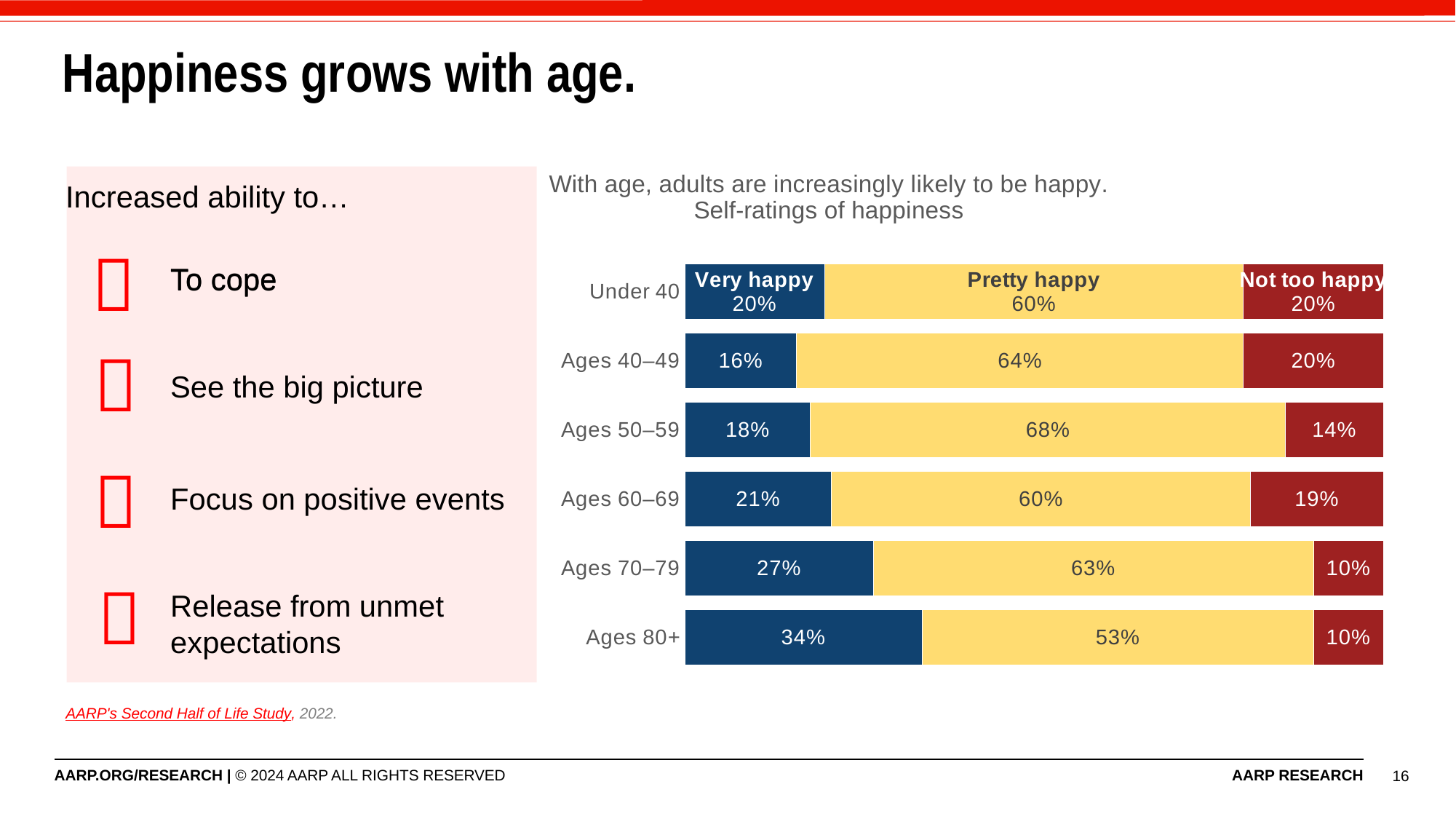
Which age group has the lowest share of very happy adults? Ages 40–49 What is the difference between the very happy share for ages 80+ and for under 40? 14 percentage points What percentage of adults aged 80+ rate themselves as very happy? 34% What colour represents the not too happy category in the chart? Dark red What percentage of adults aged 50–59 rate themselves as pretty happy? 68% Does the very happy share generally rise or fall as age increases from ages 40–49 to ages 80+? Rise What percentage of adults aged 40–49 rate themselves as not too happy? 20% How many age groups are shown in the chart? 6 Which age group has the highest share of very happy adults? Ages 80+ How many happiness categories are shown in each bar? 3 Which is larger: the not too happy share for ages 60–69 or for ages 70–79? Ages 60–69 What kind of chart is shown on the slide? Stacked bar chart